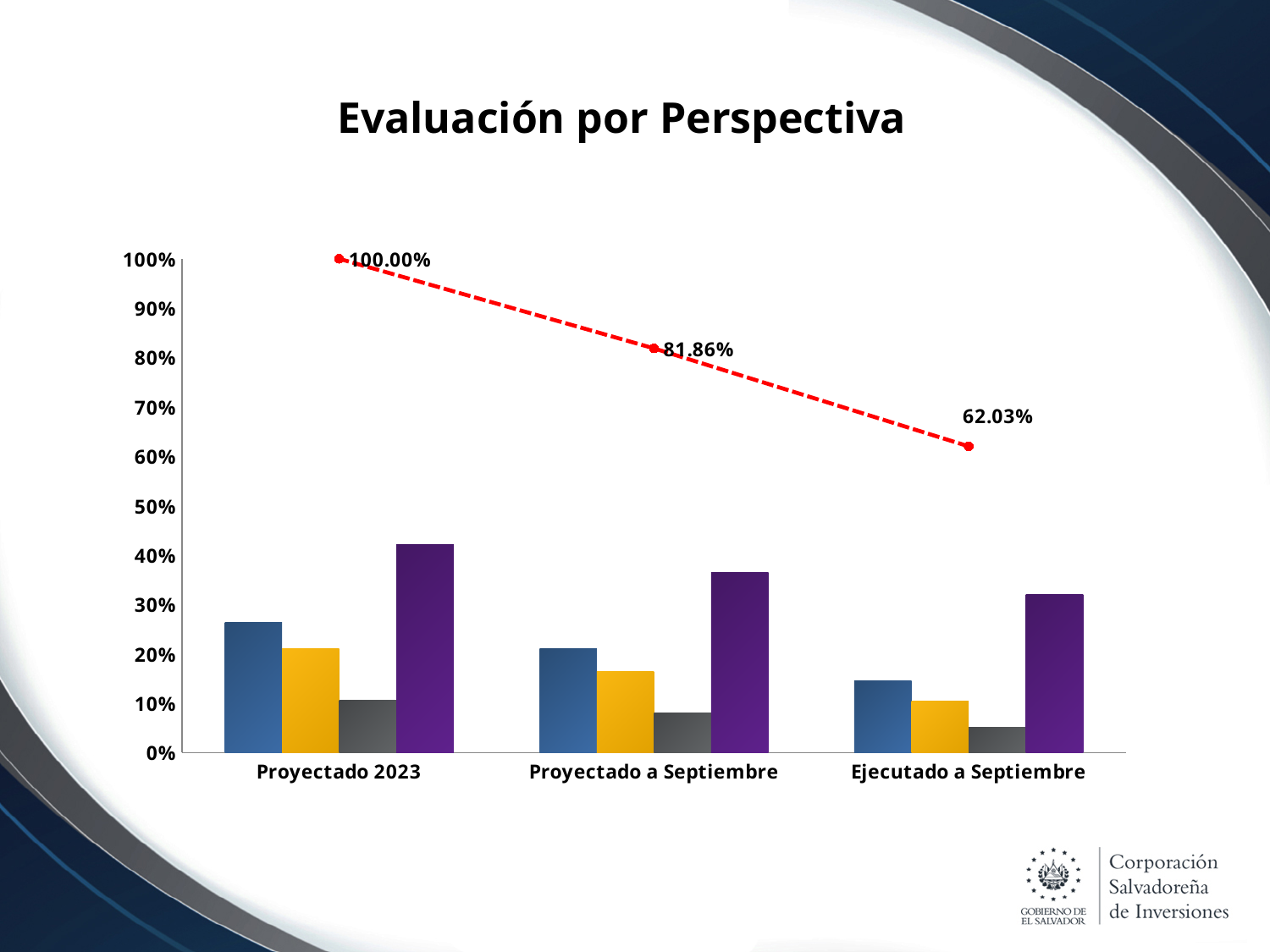
What is the difference between the line values for Proyectado 2023 and Proyectado a Septiembre? 18.14% What value does the dashed red line show for Proyectado 2023? 100.00% What is the difference between the line values for Proyectado a Septiembre and Ejecutado a Septiembre? 19.83% Which category has the lowest value on the dashed red line? Ejecutado a Septiembre What is the title of the chart? Evaluación por Perspectiva Does the dashed red line rise or fall from Proyectado 2023 to Ejecutado a Septiembre? fall What value does the dashed red line show for Ejecutado a Septiembre? 62.03% Is the purple bar for Proyectado 2023 greater or less than 40%? greater Is the blue bar for Ejecutado a Septiembre greater or less than 20%? less How many categories are shown on the x axis? 3 What value does the dashed red line show for Proyectado a Septiembre? 81.86% What kind of chart is shown on the slide? Combined bar and line chart